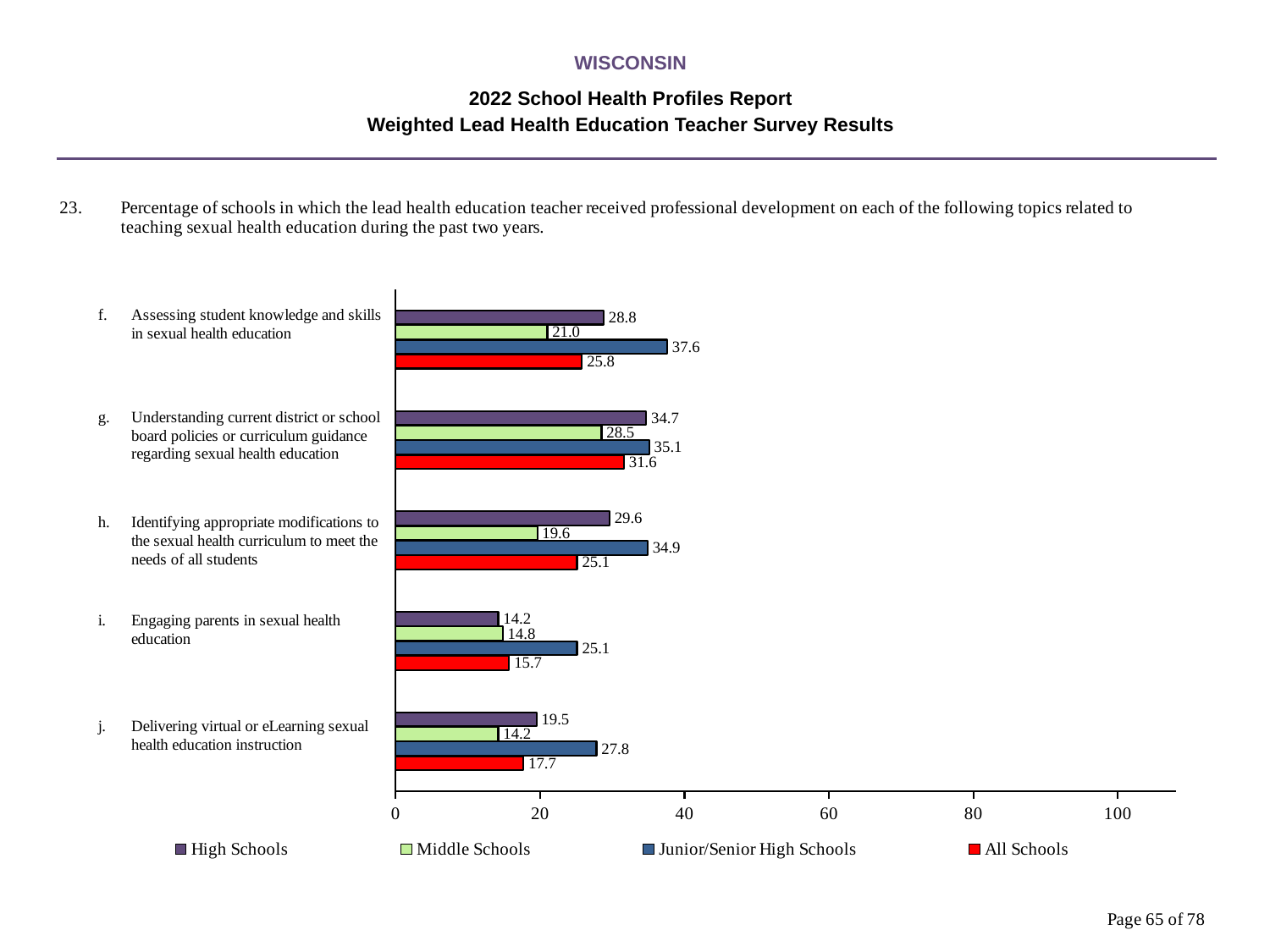
What is the All Schools value for 'Delivering virtual or eLearning sexual health education instruction'? 17.7 Which topic has the highest All Schools value? Understanding current district or school board policies or curriculum guidance regarding sexual health education Which topic has the lowest High Schools value? Engaging parents in sexual health education How many series does the legend list? 4 For 'Understanding current district or school board policies or curriculum guidance regarding sexual health education', which is larger: the High Schools value or the Middle Schools value? High Schools What kind of chart is shown on the slide? Bar chart What is the value for Junior/Senior High Schools for 'Assessing student knowledge and skills in sexual health education'? 37.6 Is the Junior/Senior High Schools value for 'Engaging parents in sexual health education' greater or less than 20? greater Which series is shown in red in the legend? All Schools What is the value for Middle Schools for 'Engaging parents in sexual health education'? 14.8 What is the difference between the Junior/Senior High Schools and Middle Schools values for 'Identifying appropriate modifications to the sexual health curriculum to meet the needs of all students'? 15.3 How many topics are shown on the chart? 5